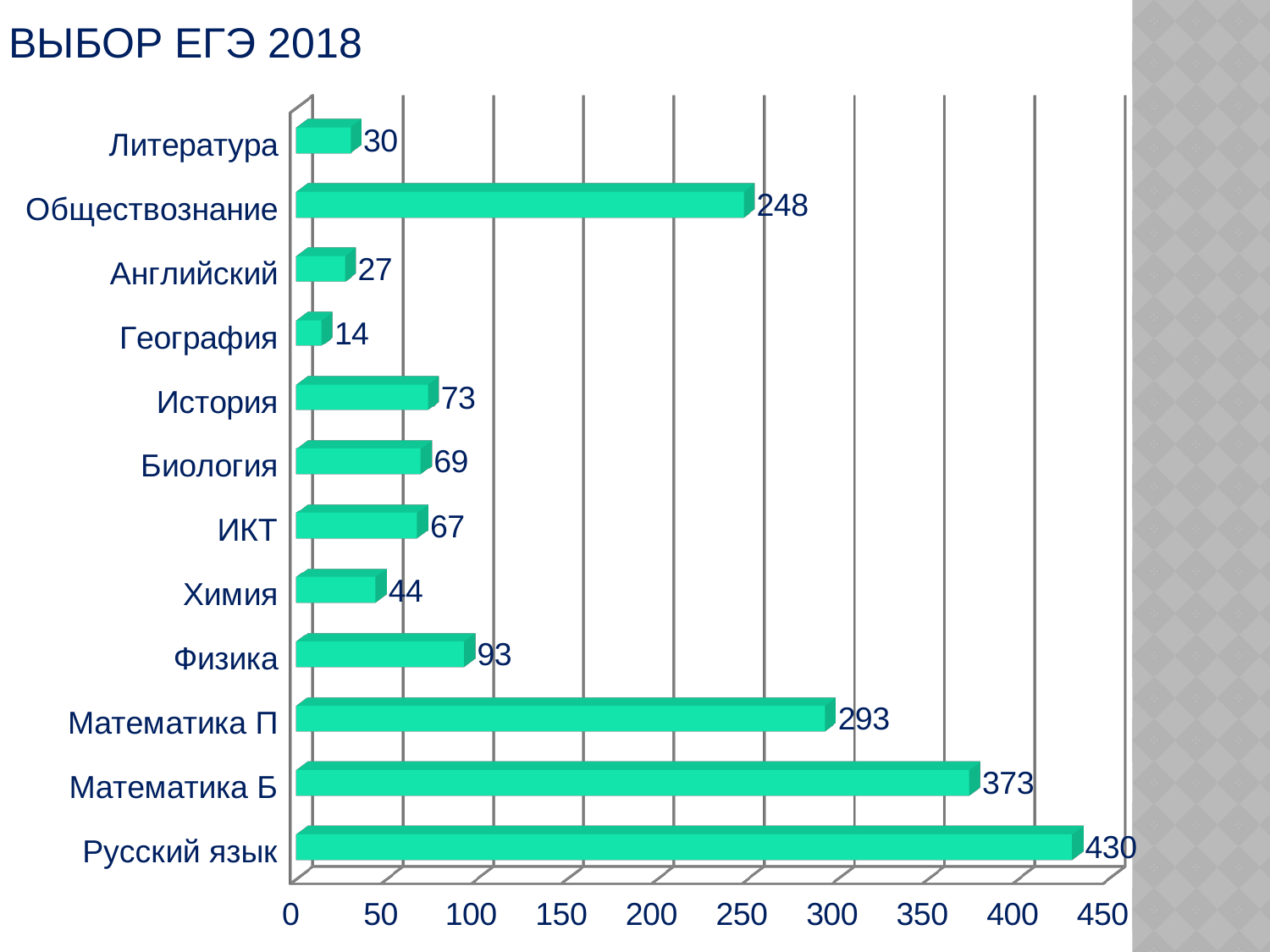
What kind of chart is shown on the slide? bar chart What is the value for Русский язык? 430 Which category has the highest value? Русский язык What is the difference between the values for Математика Б and Математика П? 80 How many categories are shown in the chart? 12 What is the value for Обществознание? 248 What is the difference between the values for Биология and ИКТ? 2 What is the value for География? 14 Which is larger, the value for Физика or the value for История? Физика Which category has the lowest value? География What is the title of the slide? ВЫБОР ЕГЭ 2018 Is the value for Обществознание greater or less than 200? greater